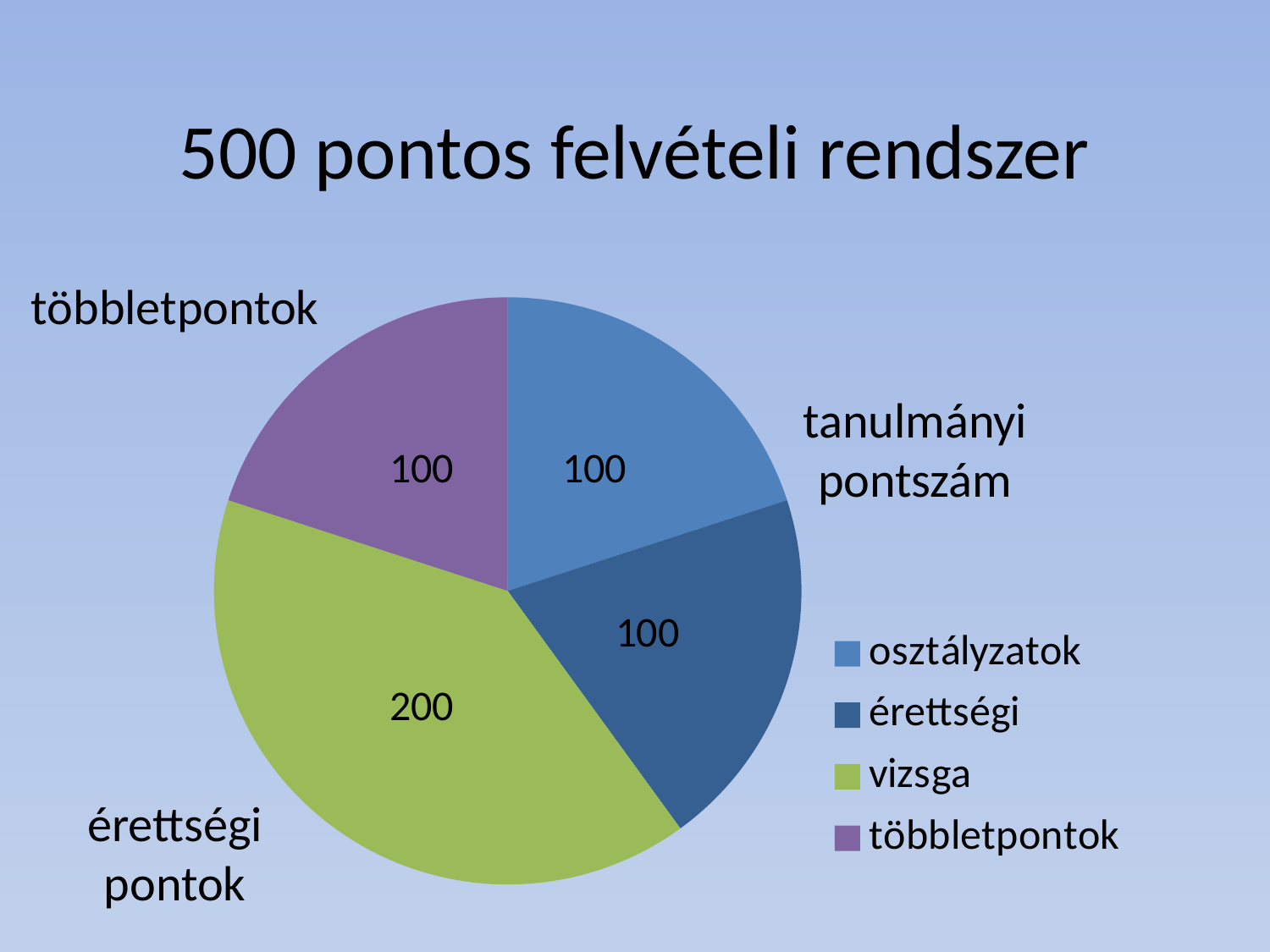
Which slice has the largest value? vizsga What kind of chart is shown on the slide? pie chart How many entries does the legend list? 4 What is the title of the slide? 500 pontos felvételi rendszer What share of the pie does the vizsga slice represent? 40% What is the value of the osztályzatok slice? 100 What is the value of the többletpontok slice? 100 What is the value of the érettségi slice? 100 Which is larger, the vizsga slice or the többletpontok slice? vizsga How many slices does the pie chart have? 4 What is the difference between the vizsga slice and the érettségi slice? 100 What is the value of the vizsga slice? 200